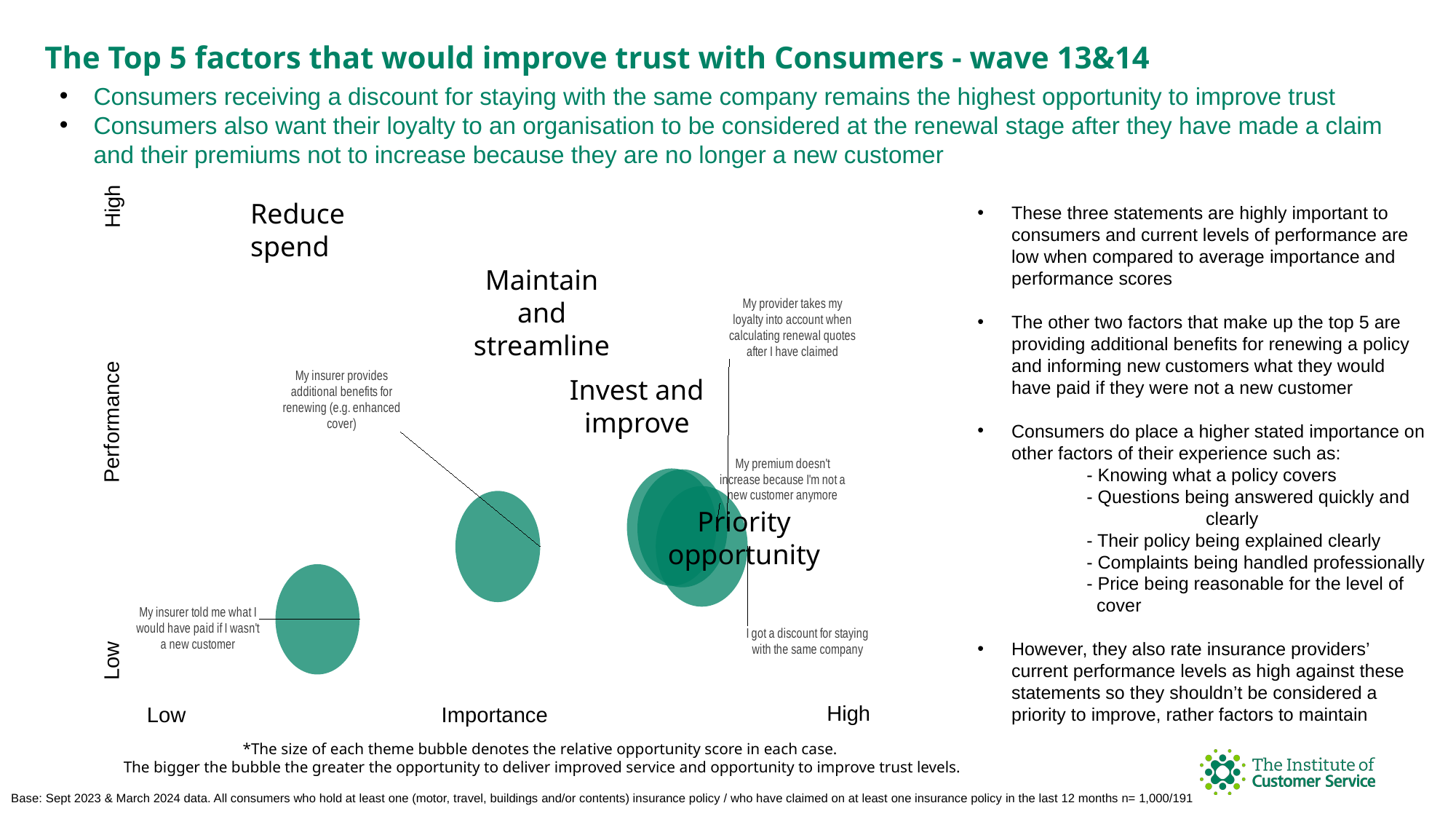
What is the label of the horizontal axis of the chart? Importance Do the bubbles generally rise or fall in performance as importance increases from left to right? Rise Which statement's bubble is furthest to the left (lowest importance) on the chart? My insurer told me what I would have paid if I wasn't a new customer Which quadrant label appears in the top-left of the chart (low importance, high performance)? Reduce spend How many bubbles are plotted on the chart? 5 Which bubble has higher importance: 'My insurer provides additional benefits for renewing (e.g. enhanced cover)' or 'My insurer told me what I would have paid if I wasn't a new customer'? My insurer provides additional benefits for renewing (e.g. enhanced cover) What kind of chart is shown on the slide? Bubble chart Which bubble has higher performance: 'My insurer provides additional benefits for renewing (e.g. enhanced cover)' or 'My insurer told me what I would have paid if I wasn't a new customer'? My insurer provides additional benefits for renewing (e.g. enhanced cover) What is the label of the vertical axis of the chart? Performance In which quadrant of the chart does the bubble 'I got a discount for staying with the same company' sit? Priority opportunity